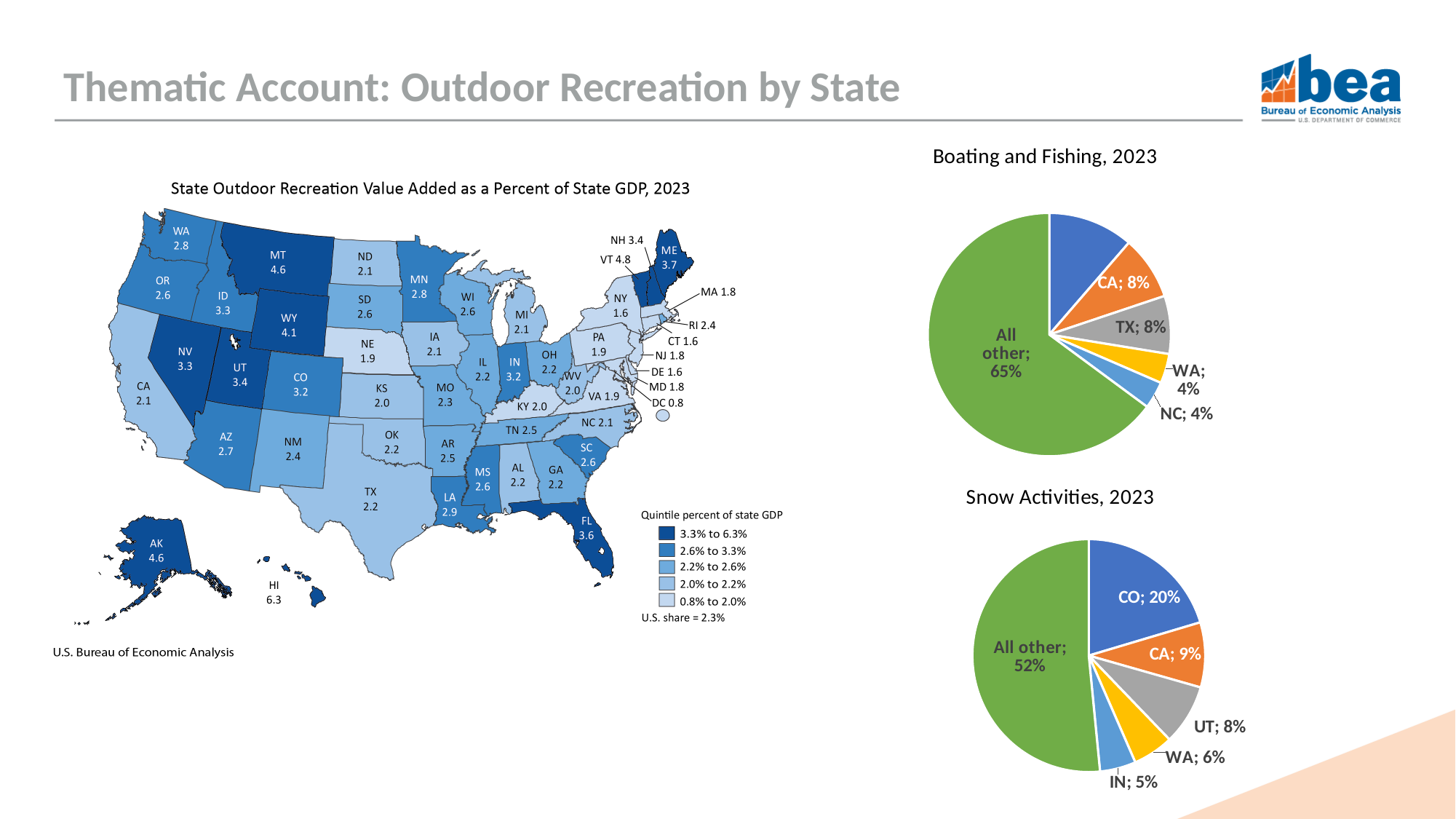
In the Snow Activities, 2023 pie chart, what share does IN have? 5% On the map of State Outdoor Recreation Value Added as a Percent of State GDP, 2023, what is the U.S. share stated in the legend? 2.3% In the Snow Activities, 2023 pie chart, what is the difference between the CO share and the UT share? 12% In the Snow Activities, 2023 pie chart, which labeled state has the largest share? CO In the Boating and Fishing, 2023 pie chart, what is the share of the All other slice? 65% On the map of State Outdoor Recreation Value Added as a Percent of State GDP, 2023, what is the value for HI? 6.3 In the Snow Activities, 2023 pie chart, which is larger, the share for CA or the share for WA? CA On the map of State Outdoor Recreation Value Added as a Percent of State GDP, 2023, which state has the lowest value shown? DC 0.8 In the Boating and Fishing, 2023 pie chart, what share does WA have? 4% What kind of chart is the Snow Activities, 2023 chart? Pie chart In the Snow Activities, 2023 pie chart, what share does CO have? 20% In the Boating and Fishing, 2023 pie chart, what share does TX have? 8%